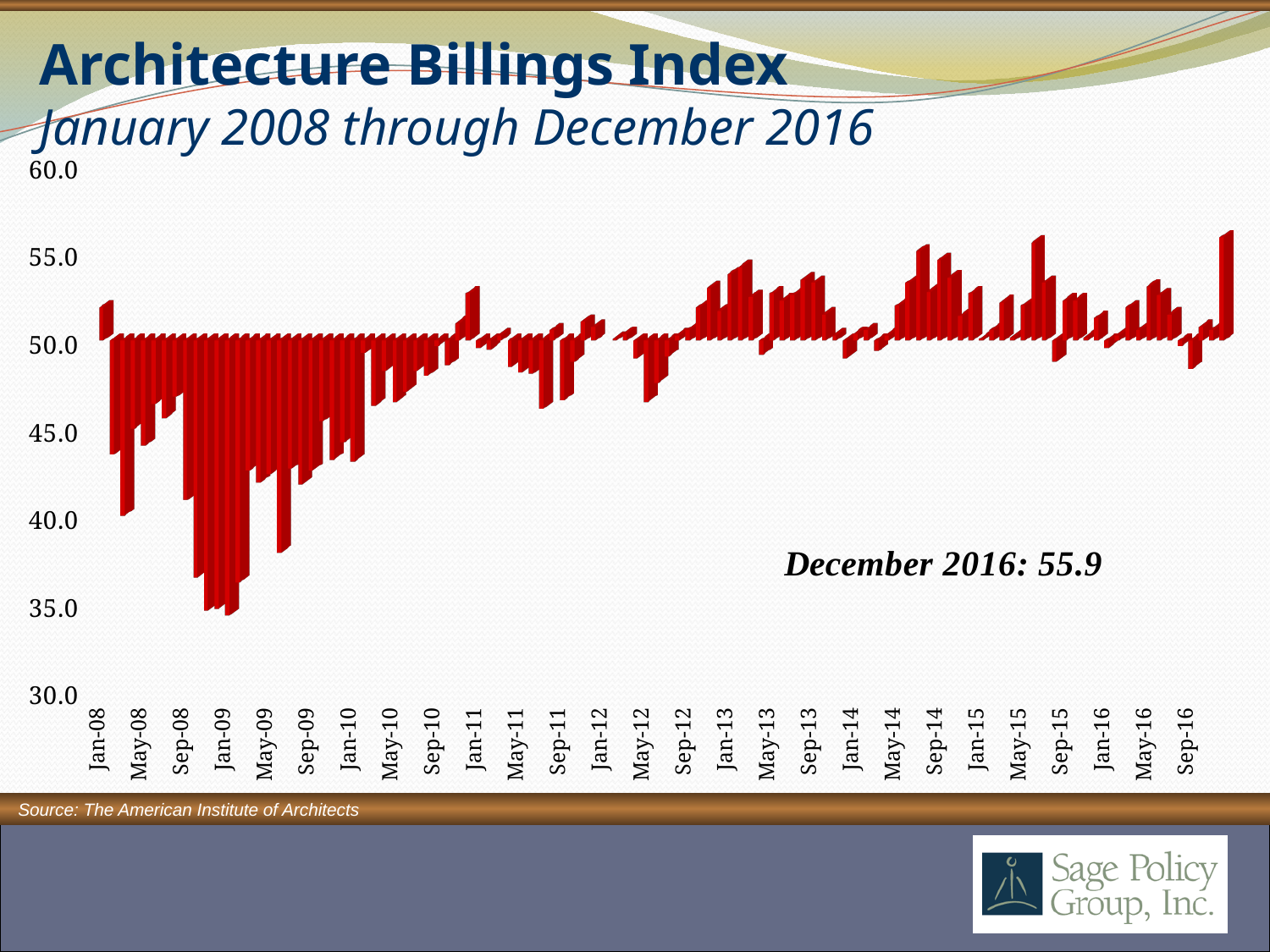
Is the value for Sep-14 greater or less than 50.0? greater What is the source of the data shown in the chart? The American Institute of Architects Do the values rise or fall from Jan-08 to Jan-09? fall Is the value for Jan-08 greater or less than 50.0? greater Is the value for Jan-09 greater or less than 40.0? less What is the title of the chart? Architecture Billings Index What is the Architecture Billings Index value for December 2016? 55.9 How many years does the chart cover, from January 2008 through December 2016? 9 What kind of chart is shown on the slide? bar chart